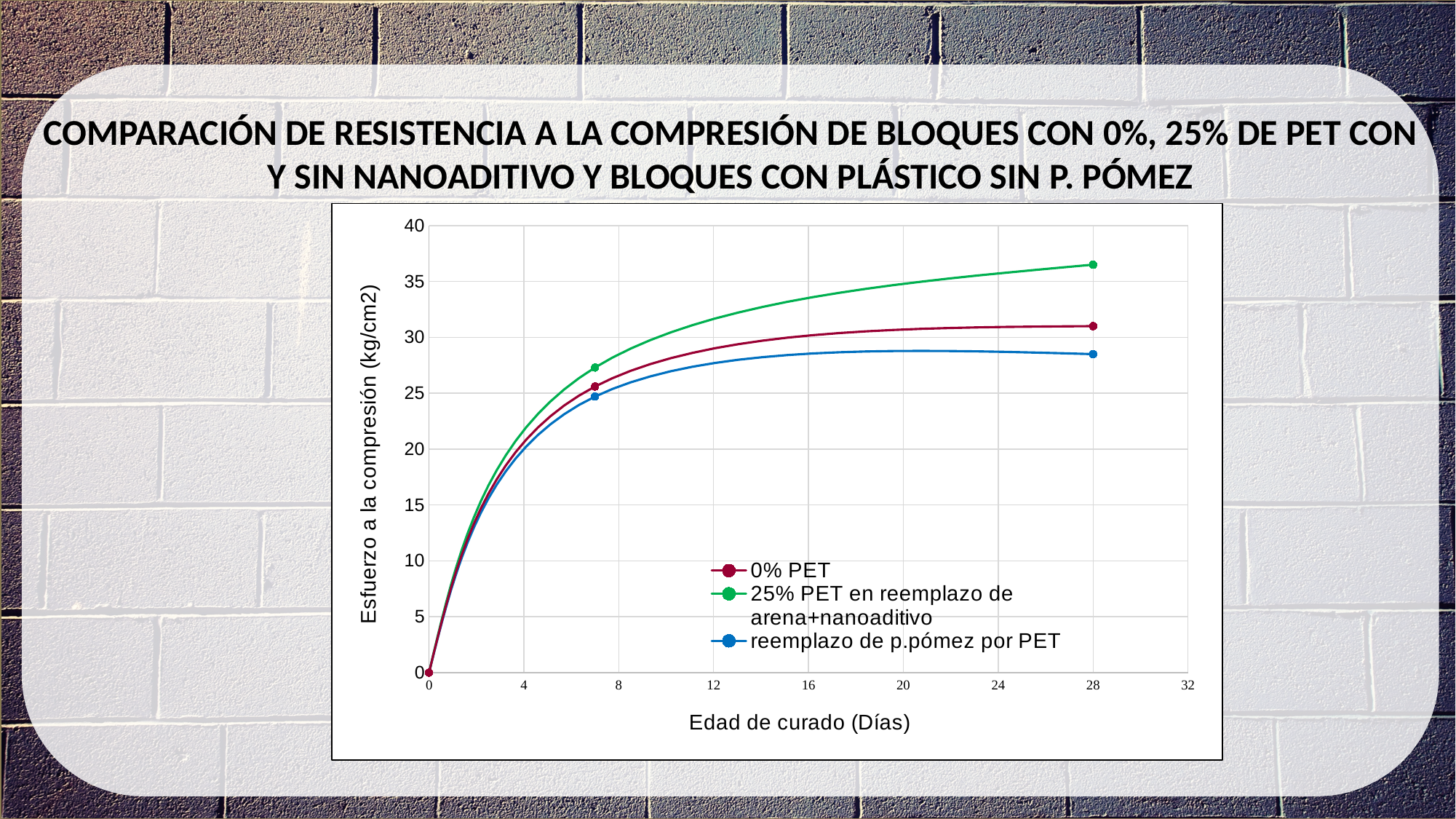
Which series has the lowest compressive strength at 28 days? reemplazo de p.pómez por PET Do the values for '25% PET en reemplazo de arena+nanoaditivo' rise or fall as curing age increases? rise How many series does the legend list? 3 Is the value for 'reemplazo de p.pómez por PET' at 28 days greater or less than 30? less Is the value for '0% PET' at 28 days greater or less than 30? greater What is the compressive strength of all three series at 0 days? 0 Which series has the highest compressive strength at 28 days? 25% PET en reemplazo de arena+nanoaditivo At 28 days, which is larger: the value for '0% PET' or the value for 'reemplazo de p.pómez por PET'? 0% PET What kind of chart is shown on the slide? line chart Is the value for '0% PET' at 7 days greater or less than 25? greater What is the label of the y axis? Esfuerzo a la compresión (kg/cm2)